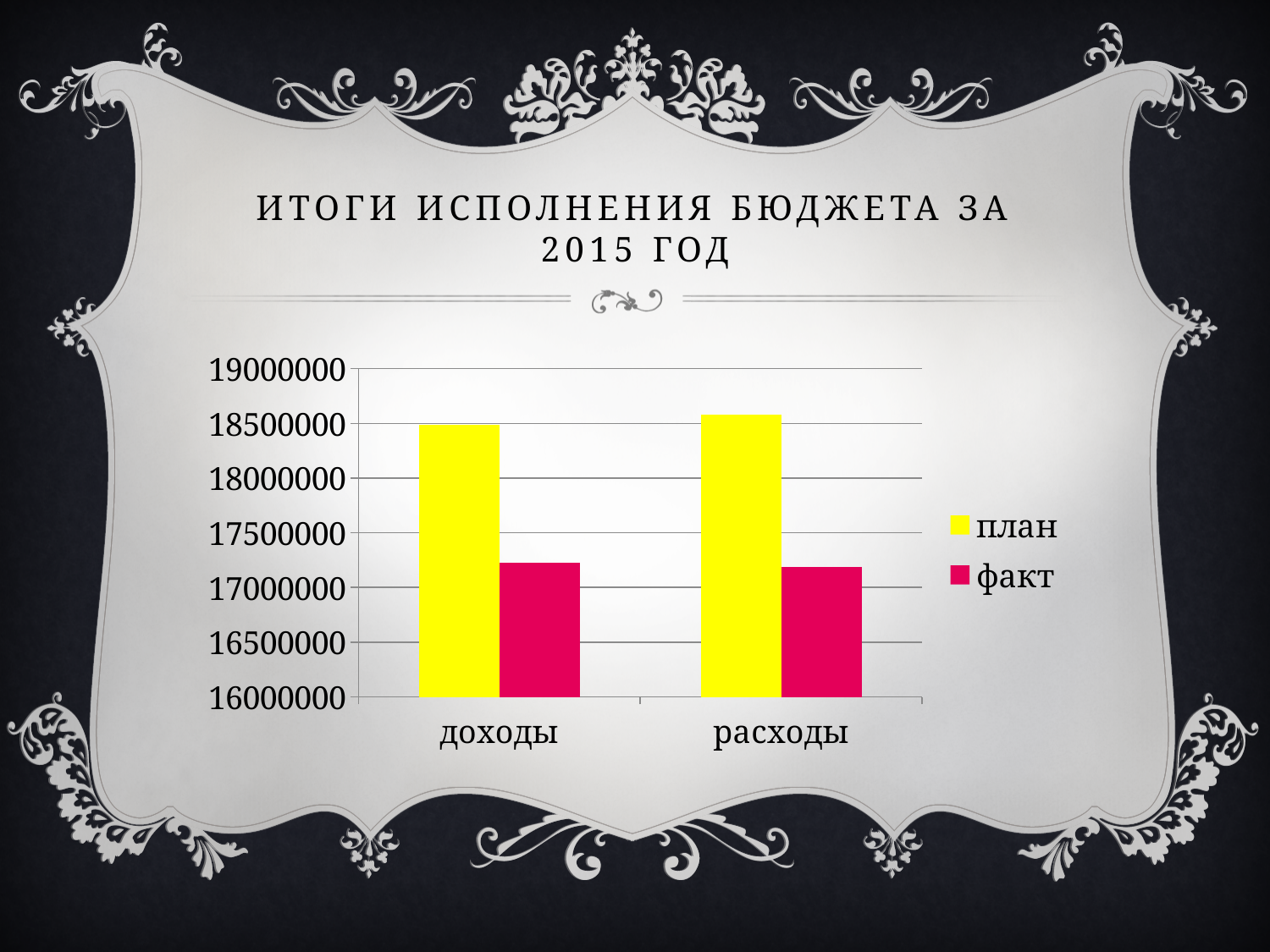
For 'расходы', which is larger: 'план' or 'факт'? план Is the 'факт' value for 'доходы' greater or less than 17000000? greater Is the 'план' value for 'доходы' greater or less than 18000000? greater How many categories are shown on the x axis of the chart? 2 What kind of chart is shown on the slide? bar chart How many series does the chart's legend list? 2 Is the 'план' value for 'расходы' greater or less than 18000000? greater What colour are the bars for the series 'план'? yellow For 'доходы', which is larger: 'план' or 'факт'? план What are the two series listed in the chart's legend? план, факт